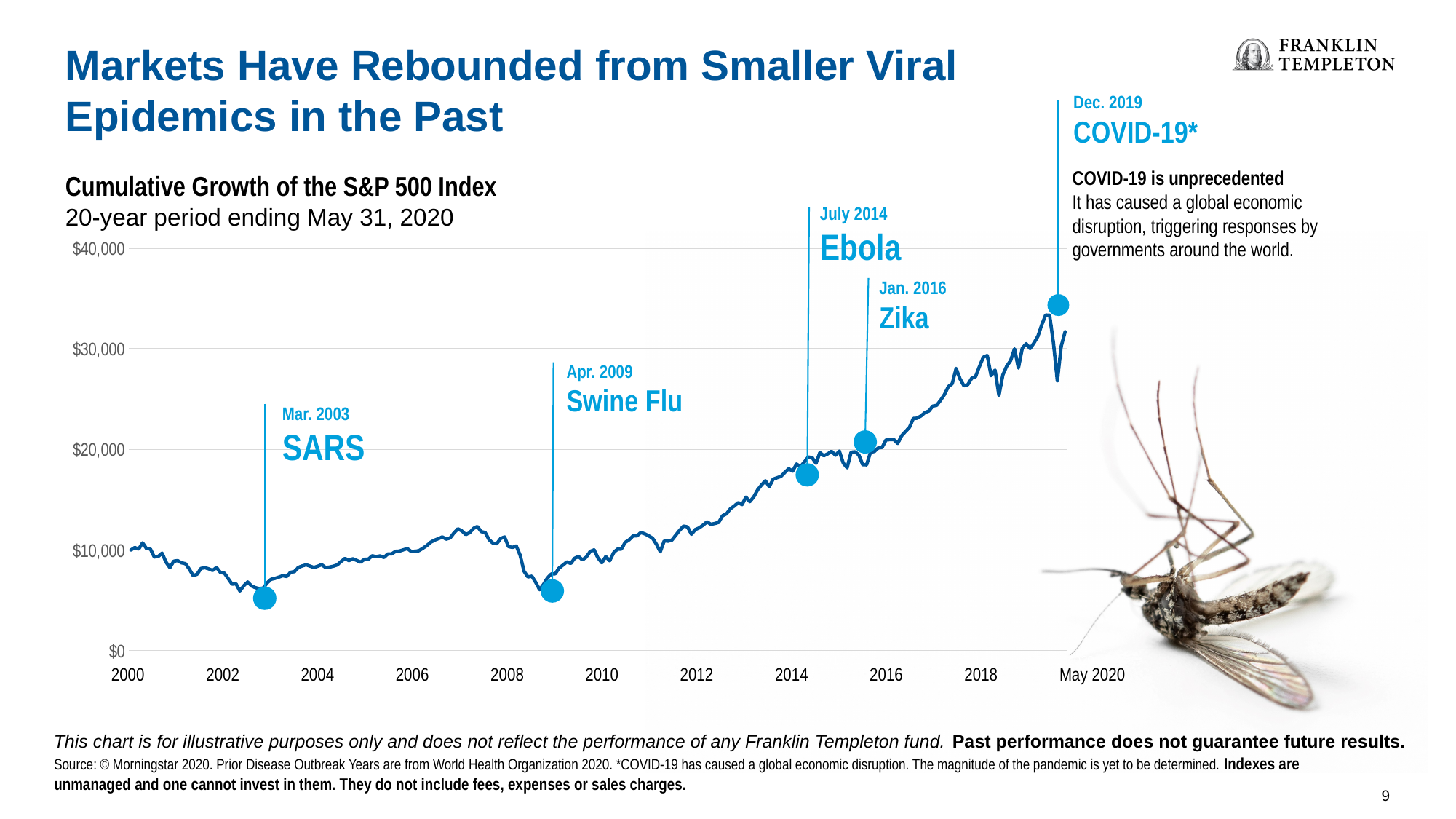
How many viral epidemics are marked on the chart? 5 What period does the chart cover, according to its subtitle? 20-year period ending May 31, 2020 Is the index value at the COVID-19 marker (Dec. 2019) greater or less than $30,000? greater Is the index value at the Swine Flu marker (Apr. 2009) greater or less than $10,000? less What kind of chart is shown on the slide? line chart Is the index value at the Ebola marker (July 2014) greater or less than $20,000? less Overall, does the S&P 500 index value rise or fall from 2000 to May 2020? rise What is the title of the chart? Cumulative Growth of the S&P 500 Index Which marked epidemic occurs at the highest index value on the chart? COVID-19 Which is larger: the index value at the Zika marker or at the Swine Flu marker? Zika